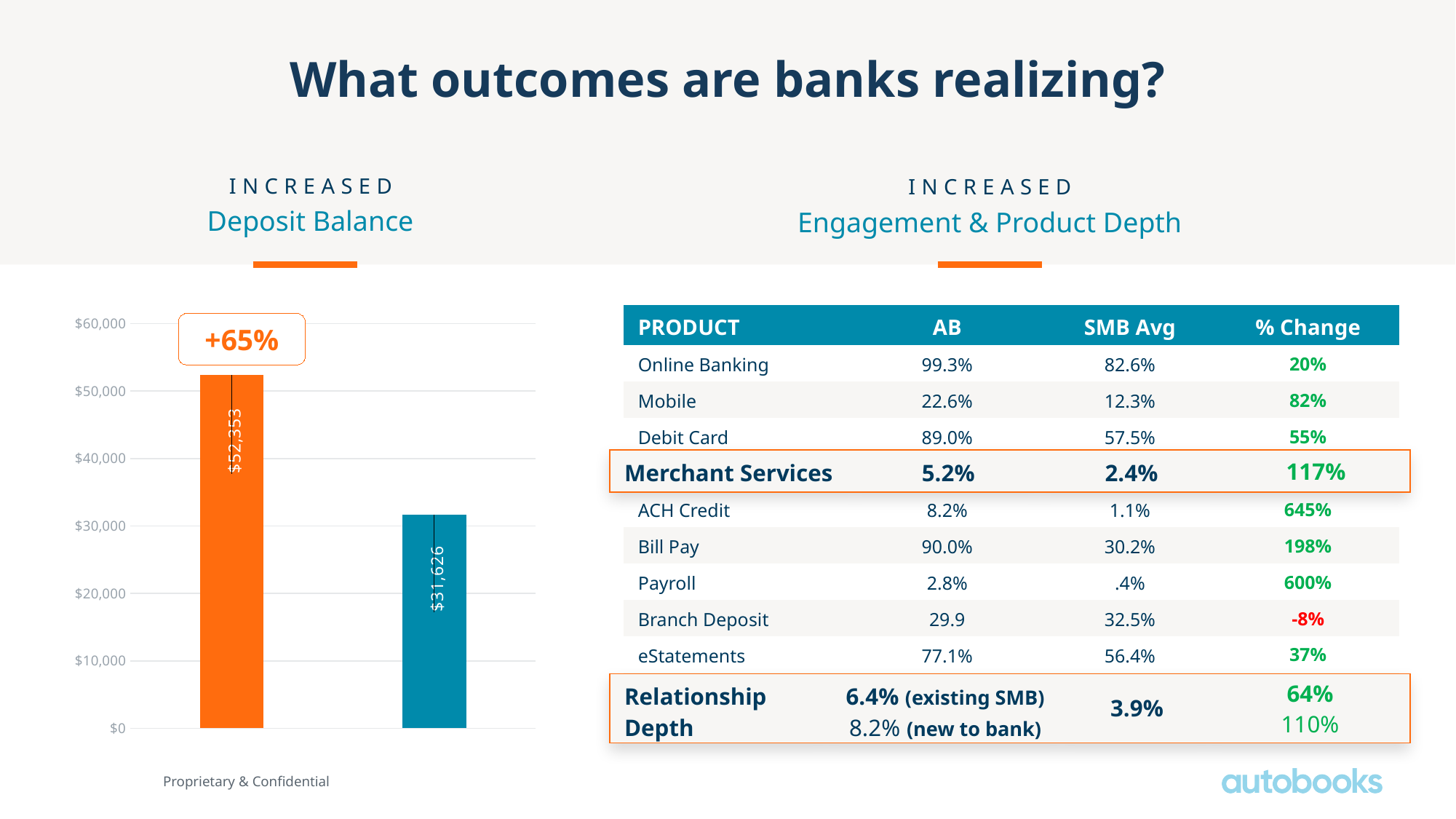
How many bars are plotted in the Deposit Balance chart? 2 In the Deposit Balance bar chart, what is the value of the shortest bar? $31,626 In the Deposit Balance bar chart, what is the value of the tallest bar? $52,353 What percentage change is shown in the callout above the orange bar in the Deposit Balance chart? +65% In the Deposit Balance bar chart, what is the difference between the orange bar and the blue bar? $20,727 In the Deposit Balance bar chart, what value is labelled on the orange bar? $52,353 What kind of chart is shown under the heading 'Increased Deposit Balance'? bar chart What is the highest value shown on the y-axis of the Deposit Balance bar chart? $60,000 In the Deposit Balance bar chart, is the value of the orange bar greater or less than $50,000? greater In the Deposit Balance bar chart, is the value of the blue bar greater or less than $40,000? less In the Deposit Balance bar chart, which bar is taller, the orange one or the blue one? the orange bar In the Deposit Balance bar chart, what value is labelled on the blue bar? $31,626